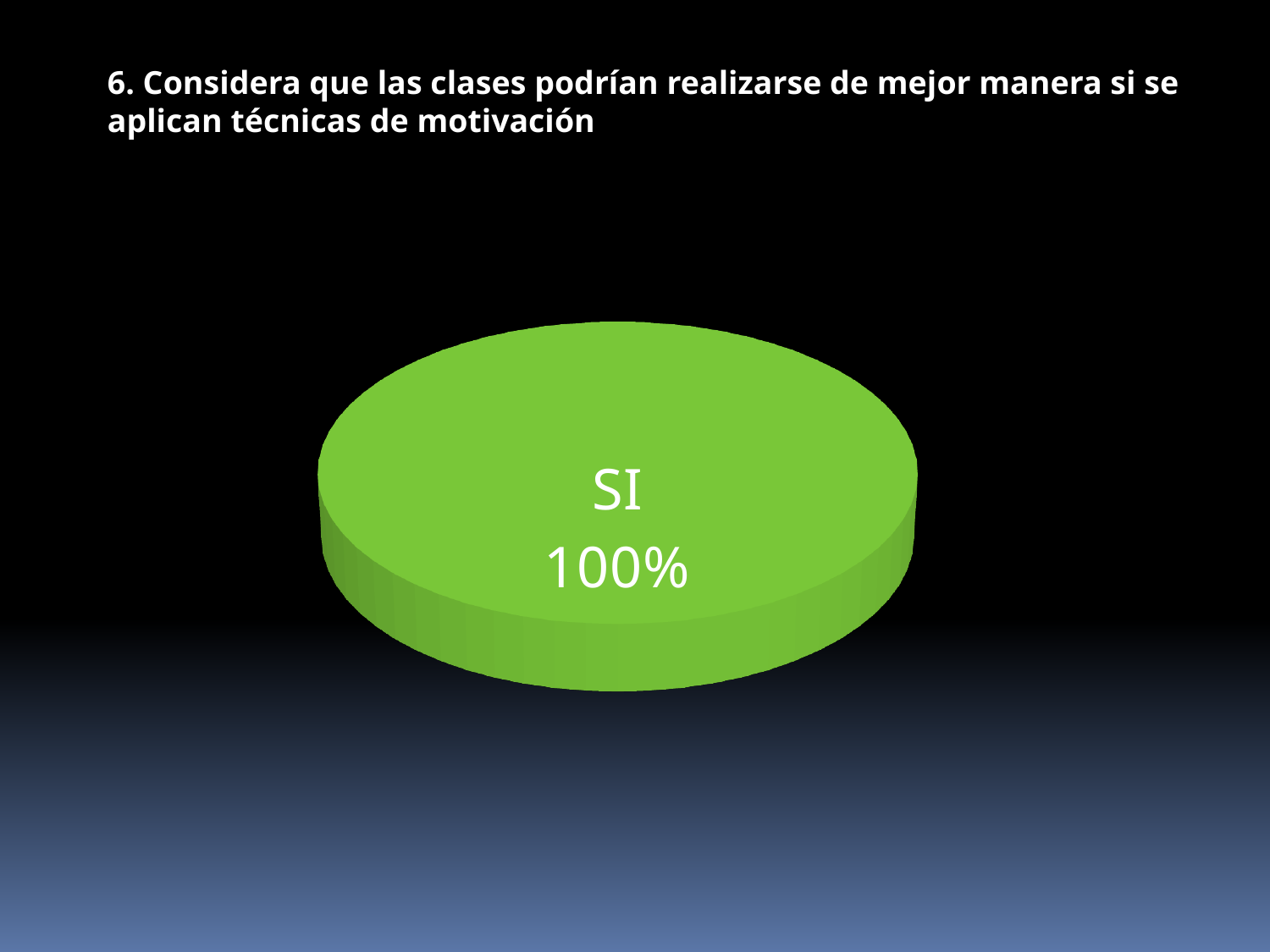
How many slices does the pie chart have? 1 Which category is the largest in the pie chart? SI What kind of chart is shown on the slide? pie chart What is the value shown for the SI category? 100% What is the label of the only slice in the pie chart? SI What colour is the SI slice of the pie chart? green What share of the pie does the SI slice represent? 100%